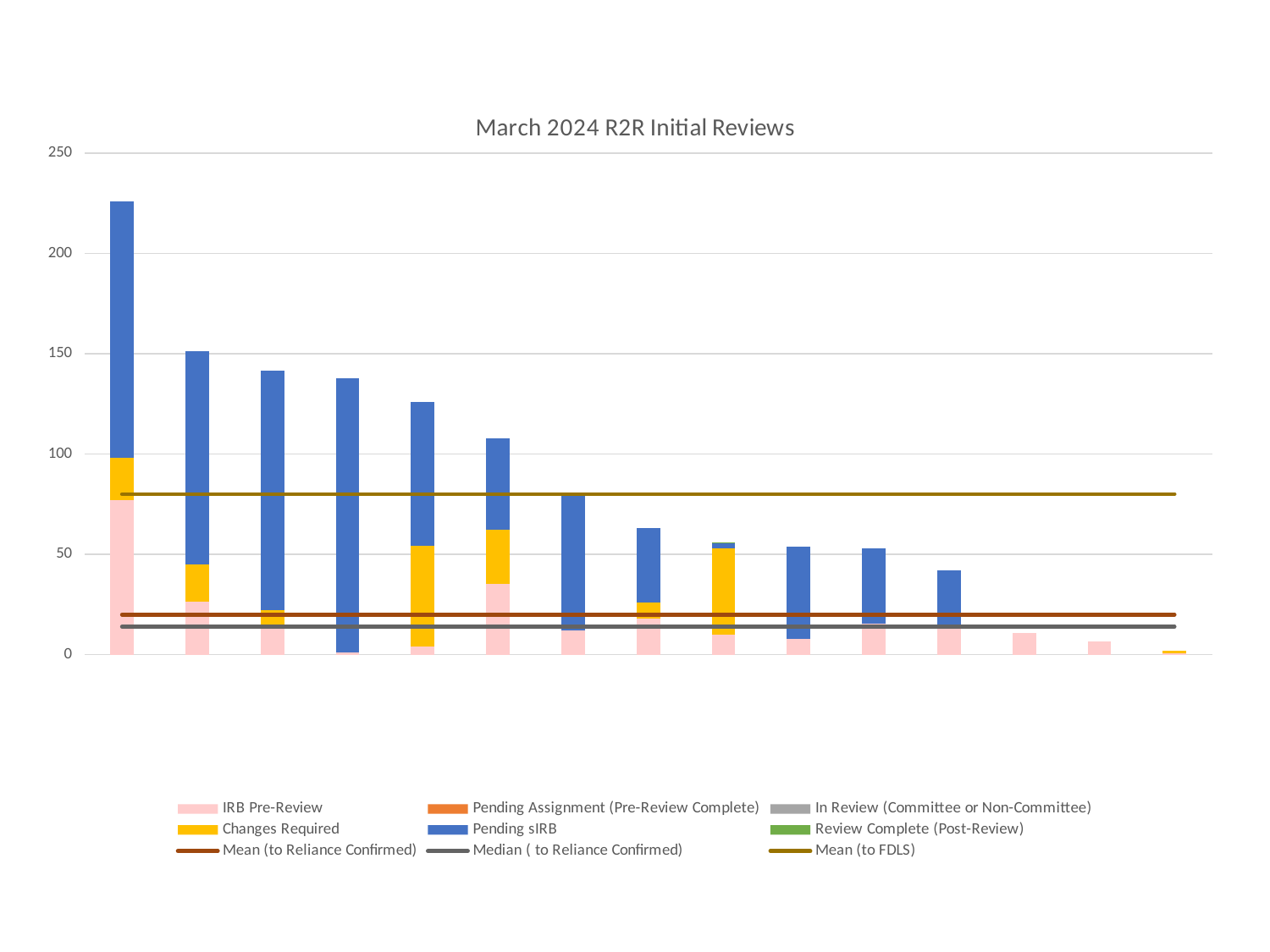
Which series is shown in blue in the stacked bars? Pending sIRB Is the total of the seventh bar from the left greater or less than 100? less Is the total of the third bar from the left greater or less than 150? less Which bar has the highest total value? The leftmost bar How many bars are plotted in the chart? 15 Is the total of the leftmost bar greater or less than 200? greater What kind of chart is shown on the slide? Stacked bar chart with line overlays Which bar has the lowest total value? The rightmost bar How many entries does the chart's legend list? 9 What is the title of the chart? March 2024 R2R Initial Reviews Do the bar totals rise or fall moving from left to right across the chart? fall